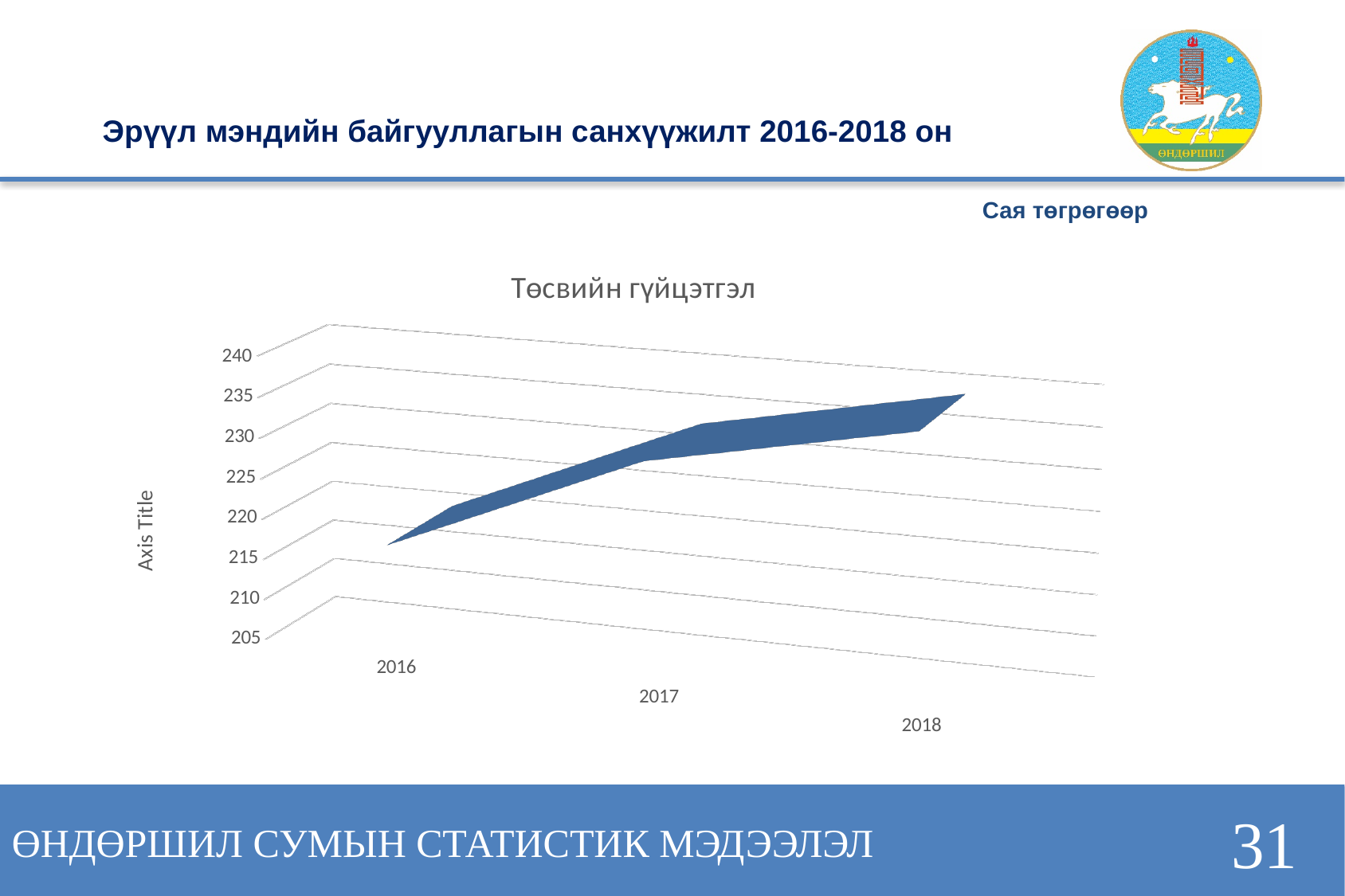
Which year has the highest value in the chart? 2018 What label is shown on the vertical axis of the chart? Axis Title Which year has the lowest value in the chart? 2016 Is the value for 2018 greater or less than 225? greater Do the values in the chart rise or fall from 2016 to 2018? rise Which year has the larger value, 2016 or 2017? 2017 How many years are plotted along the x axis of the chart? 3 Is the value for 2016 greater or less than 225? less What is the title of the chart? Төсвийн гүйцэтгэл What kind of chart is shown on the slide? line chart